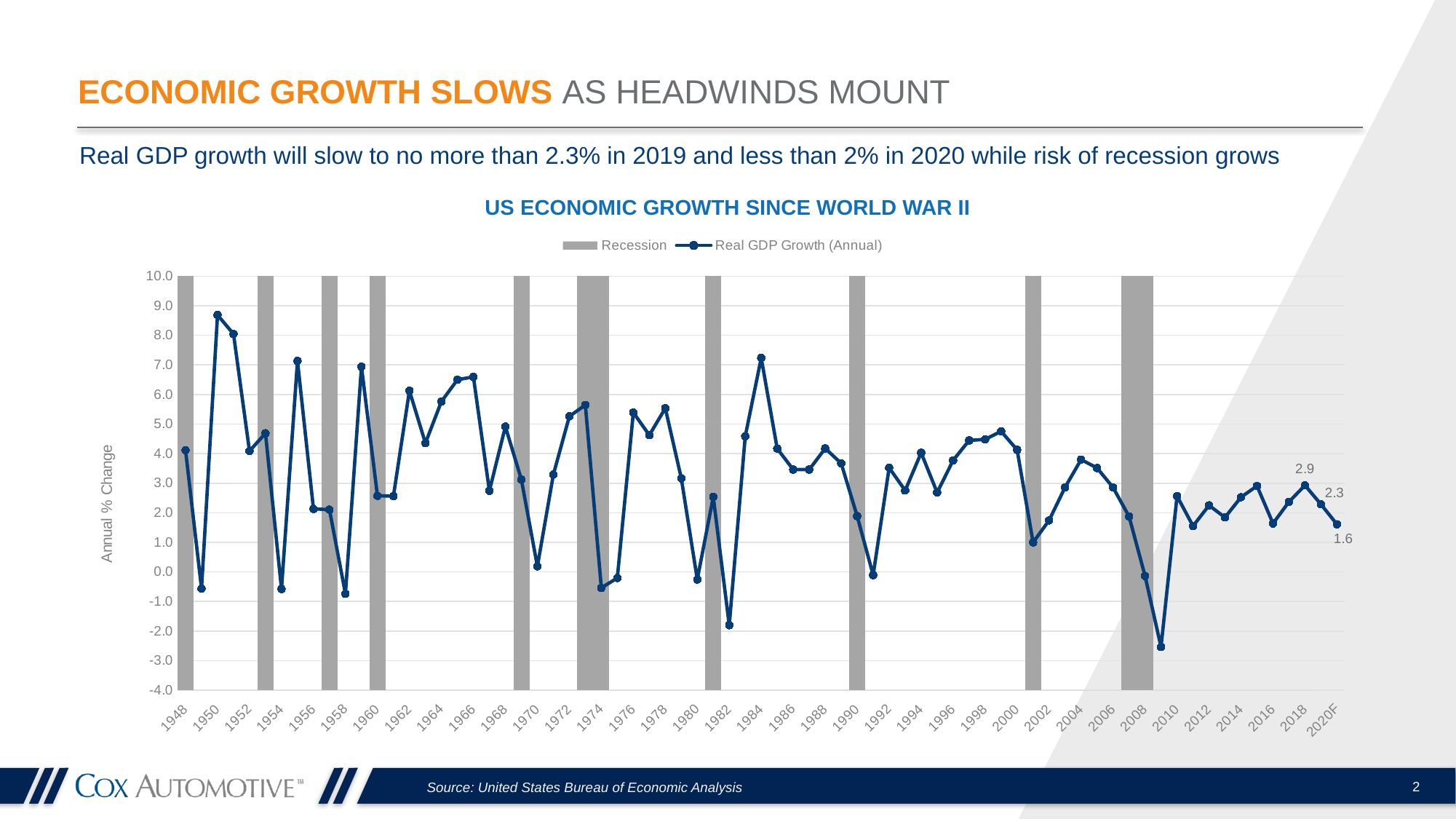
Is the Real GDP growth value for 1984 greater or less than 6.0? greater Which year has the higher labeled Real GDP growth, 2018 or 2020F? 2018 What is the labeled Real GDP growth value for 2019, the point between 2018 and 2020F? 2.3 What is the difference between the labeled values for 2018 and 2020F? 1.3 What is the title of the vertical axis? Annual % Change What kind of chart is used to show Real GDP Growth (Annual)? Line chart What is the data label shown for 2018 on the Real GDP Growth line? 2.9 Which year on the x axis shows the highest Real GDP growth? 1950 How many series does the legend list? 2 Is the Real GDP growth value for 1950 greater or less than 8.0? greater Is the Real GDP growth value for 1982 greater or less than -1.0? less What is the data label shown for 2020F on the Real GDP Growth line? 1.6